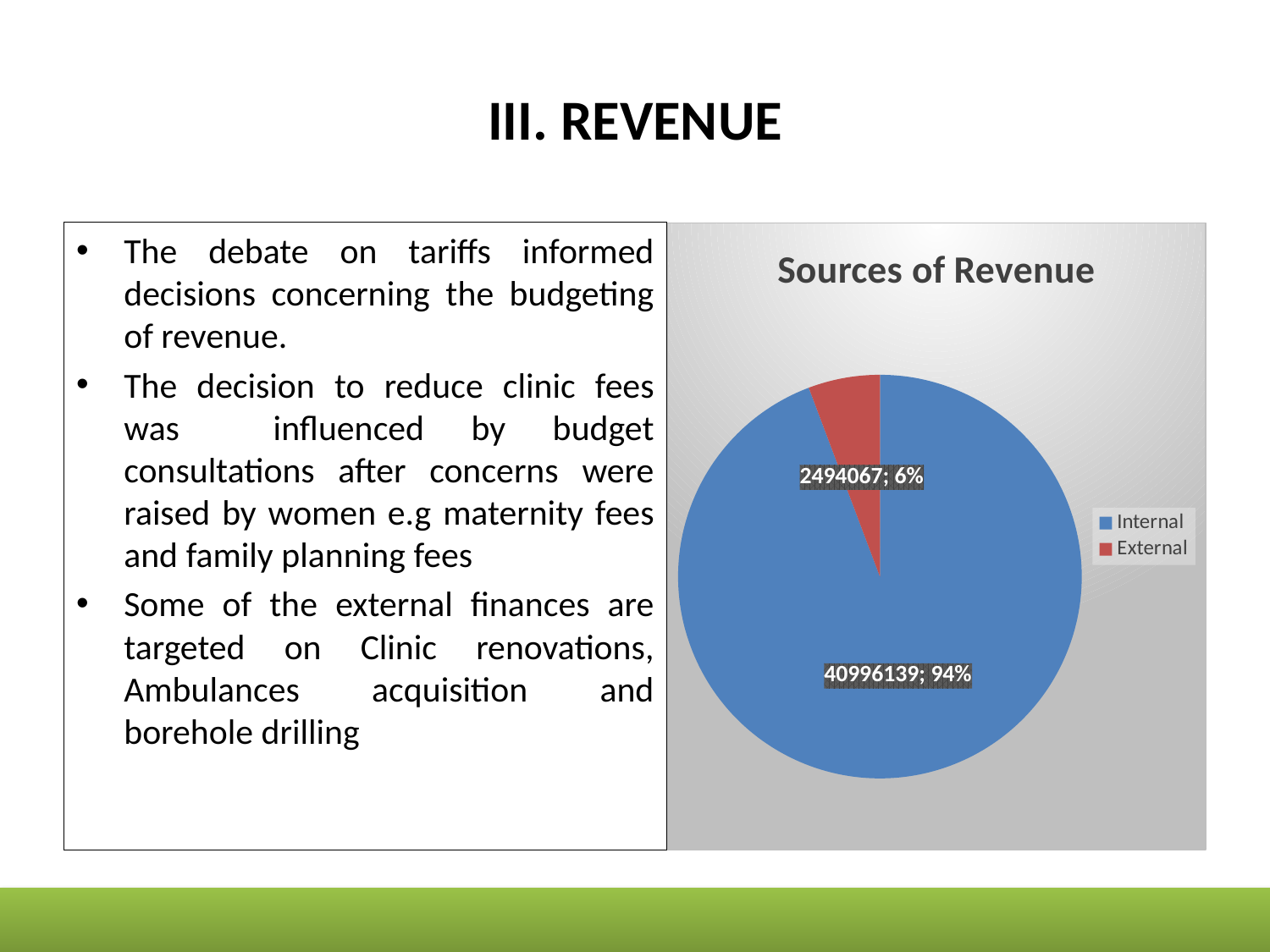
What kind of chart is shown on the slide? pie chart What is the difference between the Internal and External revenue values? 38502072 What is the value for External in the Sources of Revenue chart? 2494067 Which is larger, Internal or External revenue? Internal Which colour represents External in the chart? red What share of the pie does Internal represent? 94% Which source of revenue is the smallest? External What is the title of the chart? Sources of Revenue Which source of revenue is the largest? Internal What share of the pie does External represent? 6% What is the value for Internal in the Sources of Revenue chart? 40996139 How many slices does the pie chart have? 2